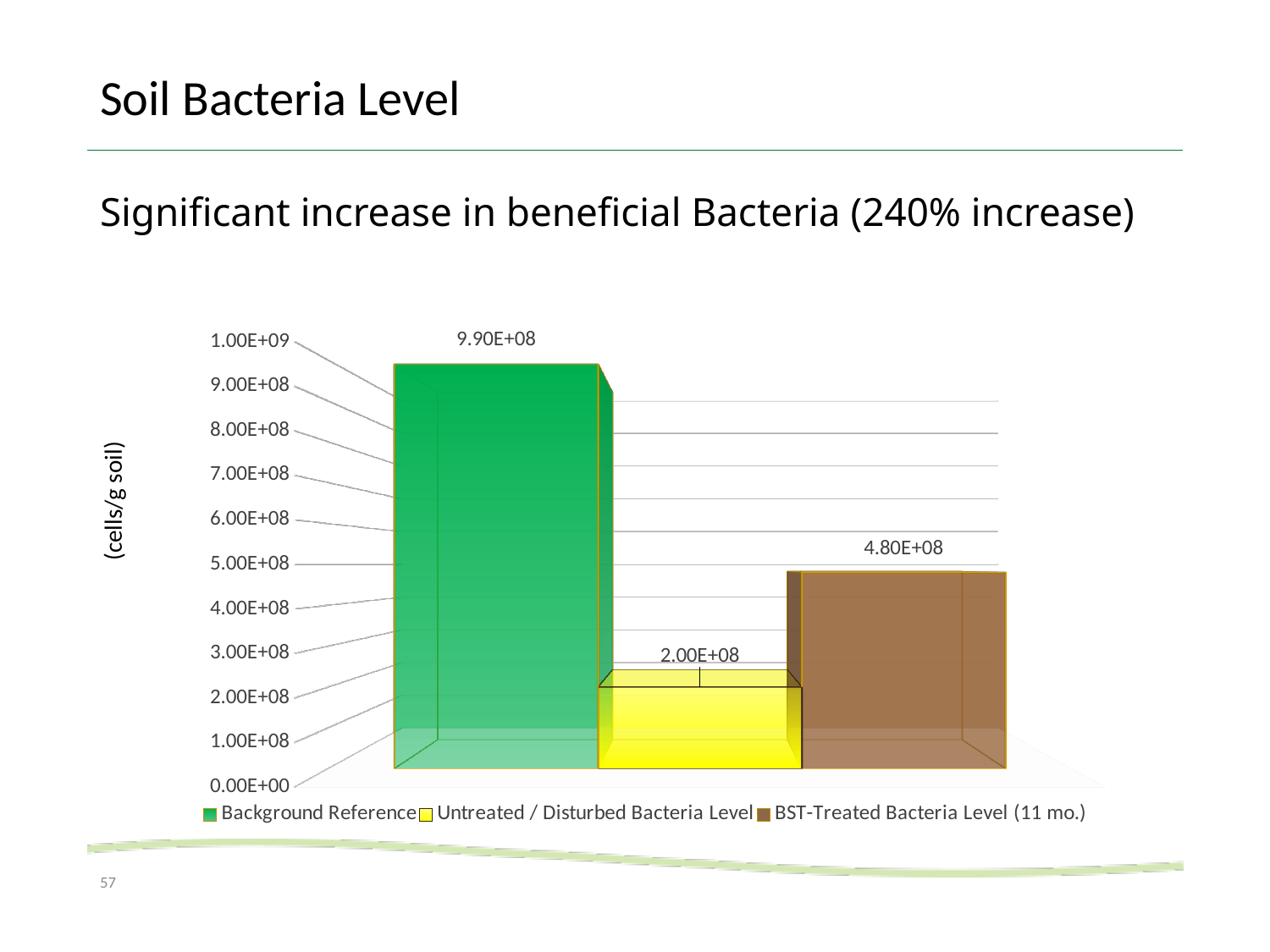
What is the difference between the Background Reference and the BST-Treated Bacteria Level (11 mo.)? 5.10E+08 What is the value for Background Reference? 9.90E+08 What is the value for BST-Treated Bacteria Level (11 mo.)? 4.80E+08 Which series has the highest value? Background Reference What is the difference between the BST-Treated Bacteria Level (11 mo.) and the Untreated / Disturbed Bacteria Level? 2.80E+08 Which series has the lowest value? Untreated / Disturbed Bacteria Level How many series does the legend list? 3 What unit is shown on the vertical axis label? (cells/g soil) What is the value for Untreated / Disturbed Bacteria Level? 2.00E+08 Is the value for BST-Treated Bacteria Level (11 mo.) greater or less than 5.00E+08? less Which is larger, the BST-Treated Bacteria Level (11 mo.) or the Untreated / Disturbed Bacteria Level? BST-Treated Bacteria Level (11 mo.) What kind of chart is shown on the slide? Bar chart